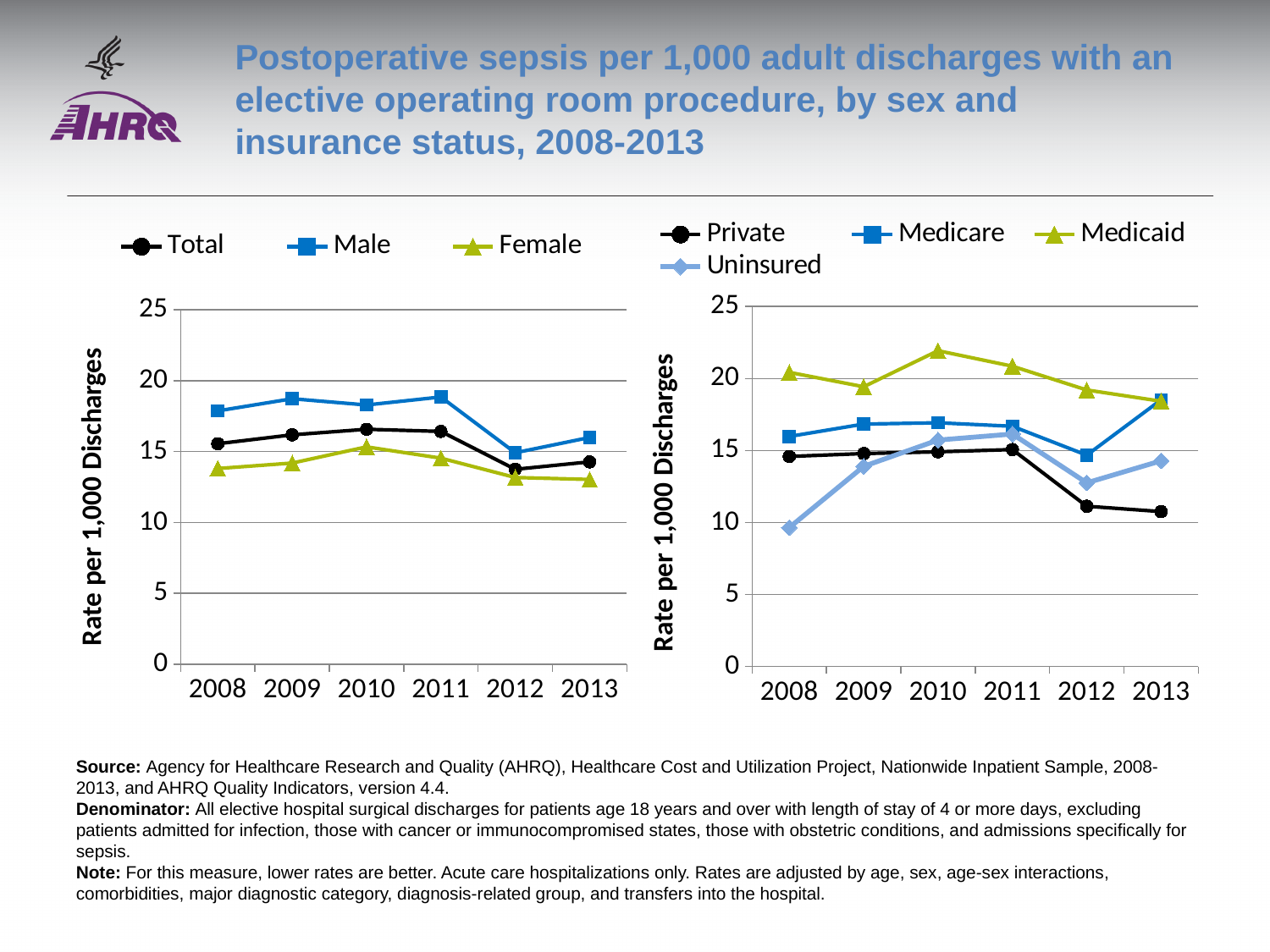
In the right chart, which series has the lowest rate in 2008? Uninsured In the left chart, which series has the highest rate in 2010? Male In the left chart, which series has the lowest rate in 2013? Female In the right chart, does the Private series rise or fall from 2011 to 2013? fall How many series does the legend of the right chart (Private, Medicare, Medicaid, Uninsured) list? 4 In the right chart, which series has the highest rate in 2008? Medicaid In the left chart, is the value for Male in 2008 greater or less than 15? greater In the right chart, which is larger in 2012: Medicaid or Medicare? Medicaid What kind of chart is the left chart (Total, Male, Female)? line chart How many years are shown on the x axis of the left chart? 6 In the left chart, is the value for Female in 2013 greater or less than 15? less